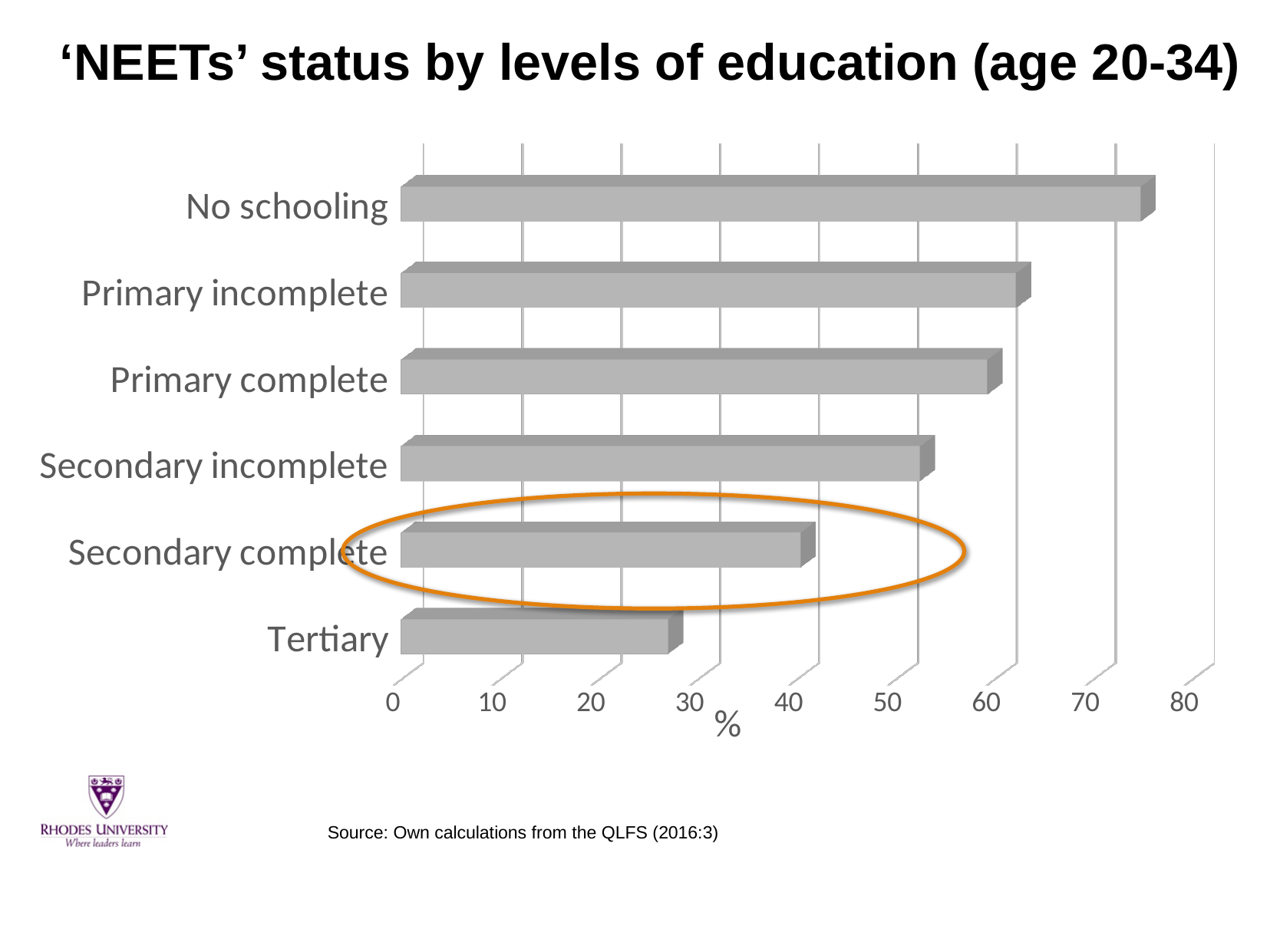
Is the value for No schooling greater or less than 70? greater Is the value for Secondary incomplete greater or less than 50? greater How many education categories are plotted in the chart? 6 Is the value for Tertiary greater or less than 30? less Which education category has the lowest NEET percentage? Tertiary Do the bar values rise or fall as you move down the categories from No schooling to Tertiary? fall Which education category has the highest NEET percentage? No schooling Which has a larger value, Secondary incomplete or Secondary complete? Secondary incomplete Which category on the chart is highlighted with an orange oval? Secondary complete What kind of chart is shown on the slide? bar chart